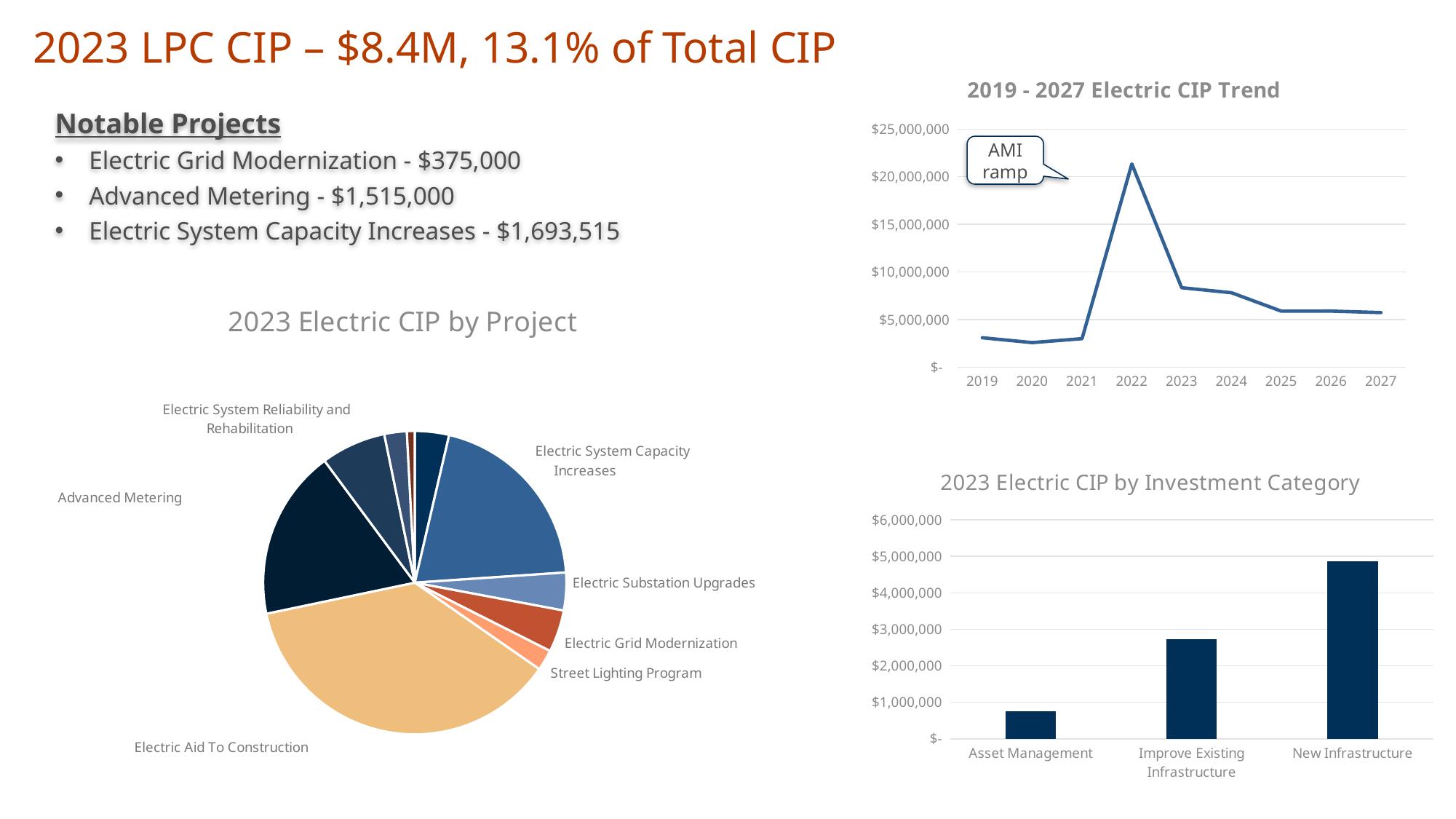
In the '2019 - 2027 Electric CIP Trend' chart, is the value for 2022 greater or less than $20,000,000? greater In the '2019 - 2027 Electric CIP Trend' chart, which year has the highest value? 2022 In the '2023 Electric CIP by Investment Category' chart, is the value for Asset Management greater or less than $1,000,000? less What kind of chart is '2023 Electric CIP by Investment Category'? bar chart In the '2019 - 2027 Electric CIP Trend' chart, do the values rise or fall from 2023 to 2027? fall What kind of chart is '2023 Electric CIP by Project'? pie chart In the '2019 - 2027 Electric CIP Trend' chart, is the value for 2019 greater or less than $5,000,000? less In the '2023 Electric CIP by Project' pie chart, which project has the largest slice? Electric Aid To Construction How many years are plotted on the '2019 - 2027 Electric CIP Trend' chart? 9 What kind of chart is '2019 - 2027 Electric CIP Trend'? line chart In the '2023 Electric CIP by Investment Category' chart, which category has the highest value? New Infrastructure In the '2023 Electric CIP by Investment Category' chart, which category has the lowest value? Asset Management